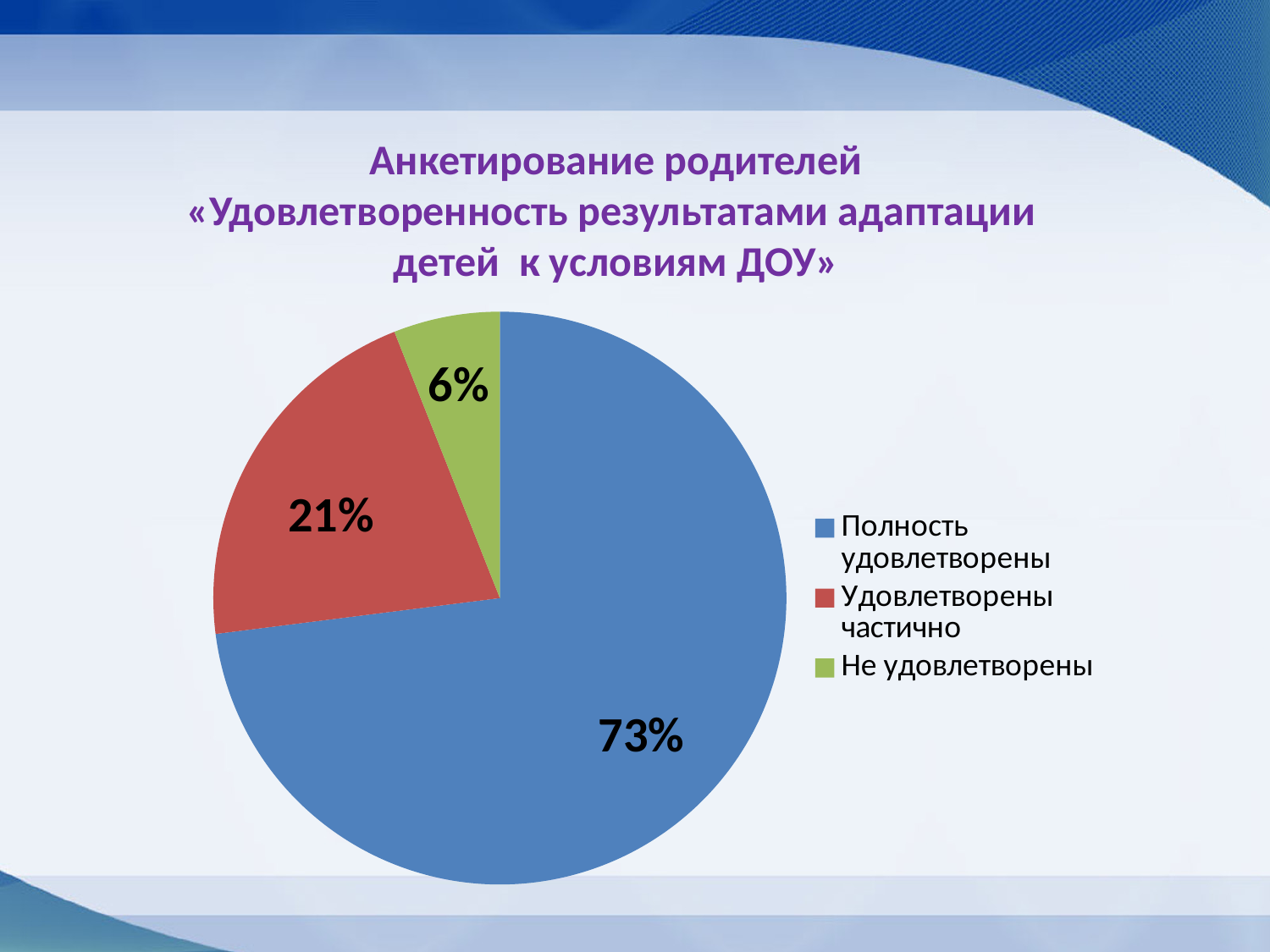
Which category has the smallest slice of the pie? Не удовлетворены What share of the pie is labelled "Удовлетворены частично"? 21% What is the difference in percentage points between "Полность удовлетворены" and "Удовлетворены частично"? 52 Which is larger: the share for "Удовлетворены частично" or the share for "Не удовлетворены"? Удовлетворены частично How many slices does the pie chart have? 3 What is the title of the survey shown above the chart? Анкетирование родителей «Удовлетворенность результатами адаптации детей к условиям ДОУ» What share of the pie is labelled "Полность удовлетворены"? 73% What kind of chart is shown on the slide? pie chart Which category has the largest slice of the pie? Полность удовлетворены What colour is the slice for "Не удовлетворены"? green How many entries does the legend list? 3 What share of the pie is labelled "Не удовлетворены"? 6%